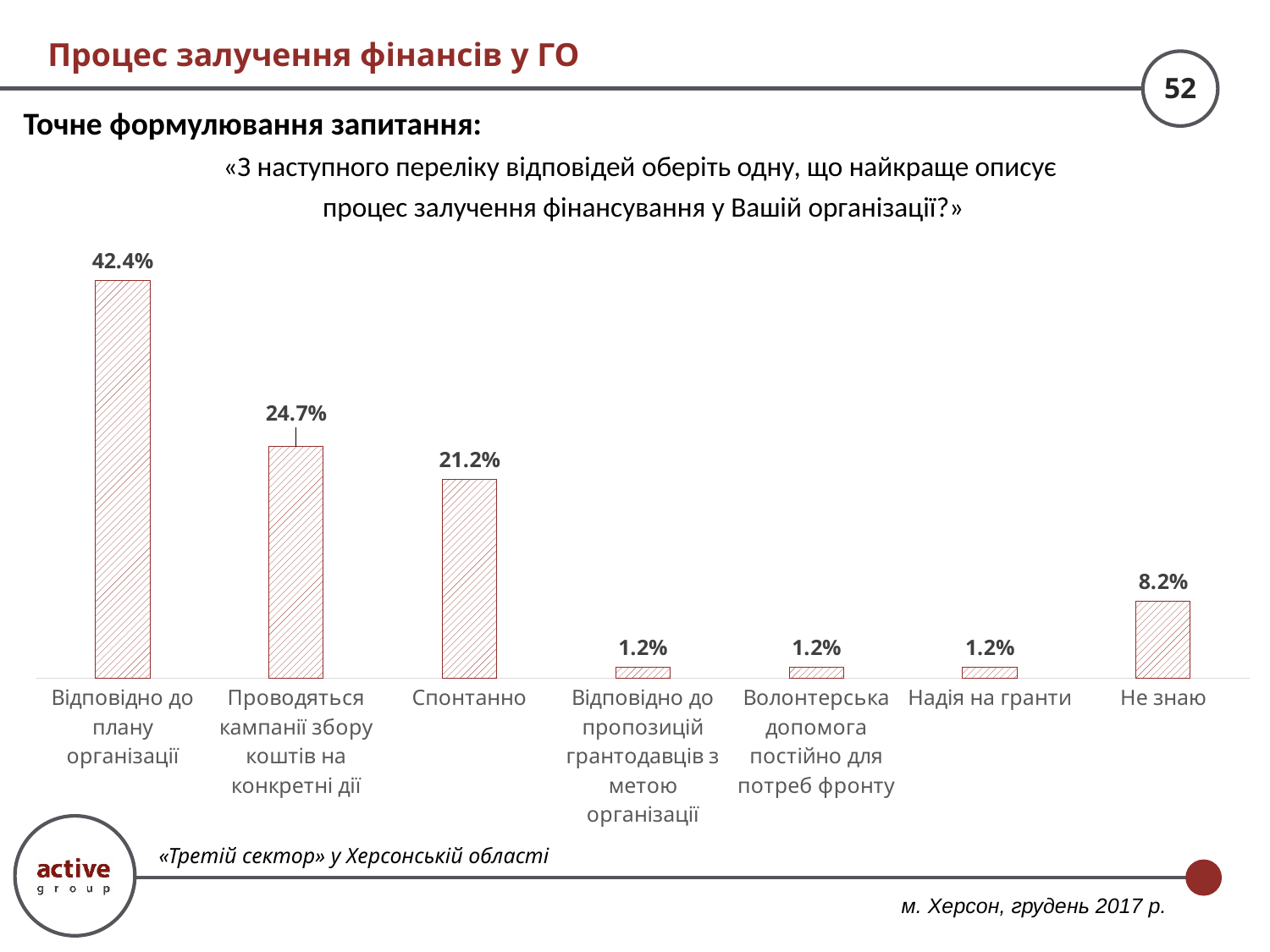
What is the difference between «Відповідно до плану організації» and «Проводяться кампанії збору коштів на конкретні дії»? 17.7% Which category has the highest value? Відповідно до плану організації What is the value for «Волонтерська допомога постійно для потреб фронту»? 1.2% What is the value for «Спонтанно»? 21.2% What is the value for «Відповідно до плану організації»? 42.4% What is the value for «Надія на гранти»? 1.2% What kind of chart is shown on the slide? Bar chart What is the value for «Не знаю»? 8.2% How many categories are shown in the chart? 7 What is the difference between «Проводяться кампанії збору коштів на конкретні дії» and «Спонтанно»? 3.5% How many categories share the lowest value of 1.2%? 3 Which is larger: «Спонтанно» or «Не знаю»? Спонтанно